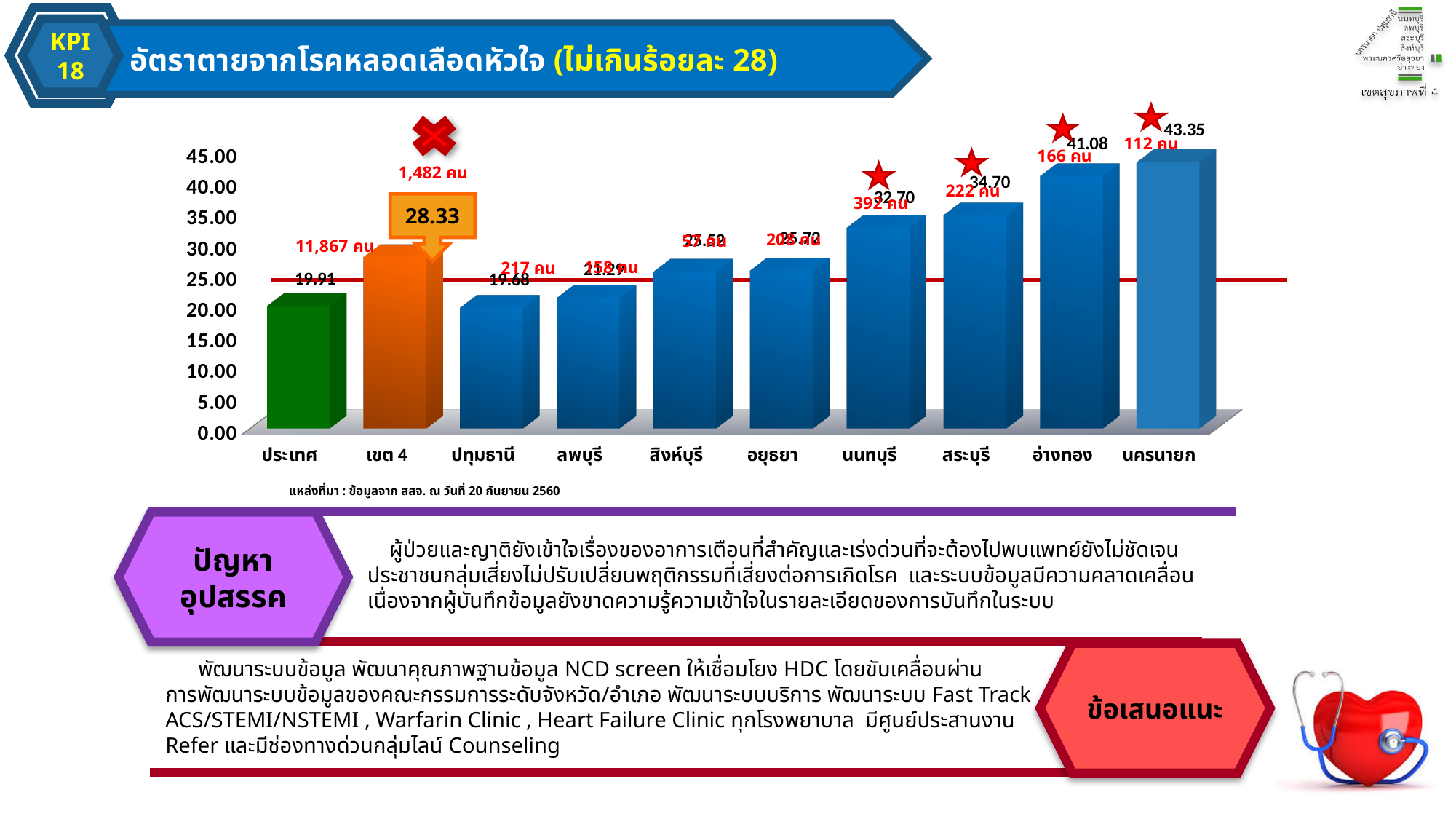
Is the value for สิงห์บุรี greater or less than 25.00? greater What is the value for ประเทศ? 19.91 Which category has the highest value? นครนายก How many categories are shown on the x axis? 10 Which is larger, the value for สระบุรี or the value for นนทบุรี? สระบุรี What is the value shown in the callout for เขต 4? 28.33 What kind of chart is shown on the slide? bar chart What is the value for นครนายก? 43.35 What is the value for อ่างทอง? 41.08 Is the value for ลพบุรี greater or less than 25.00? less What is the difference between the values for นครนายก and อ่างทอง? 2.27 What is the red count label shown above the bar for นนทบุรี? 392 คน